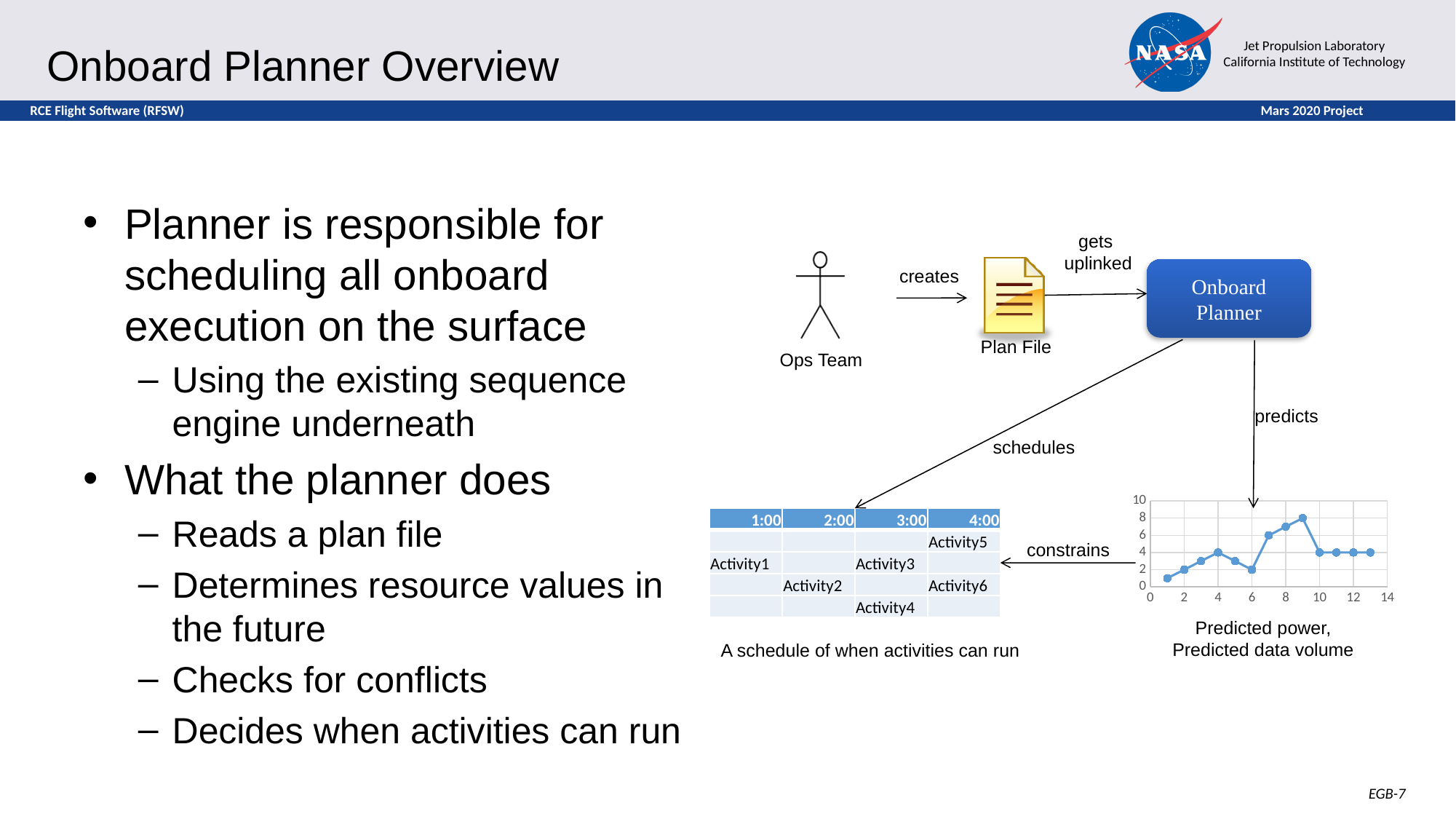
On the line chart, which is larger, the value at x = 9 or the value at x = 4? x = 9 How many data points are plotted on the line chart at the bottom right? 13 On the line chart, is the value at x = 5 greater or less than 4? less On the line chart, what is the value at x = 9? 8 What kind of chart is shown at the bottom right of the slide? line chart What is the highest value shown on the y axis of the line chart? 10 On the line chart, is the value at x = 7 greater or less than 4? greater On the line chart, at which x value is the lowest point? 1 On the line chart, do the values rise or fall between x = 9 and x = 10? fall On the line chart, is the value at x = 1 greater or less than 2? less On the line chart, do the values rise or fall between x = 6 and x = 9? rise On the line chart, at which x value does the line reach its highest point? 9